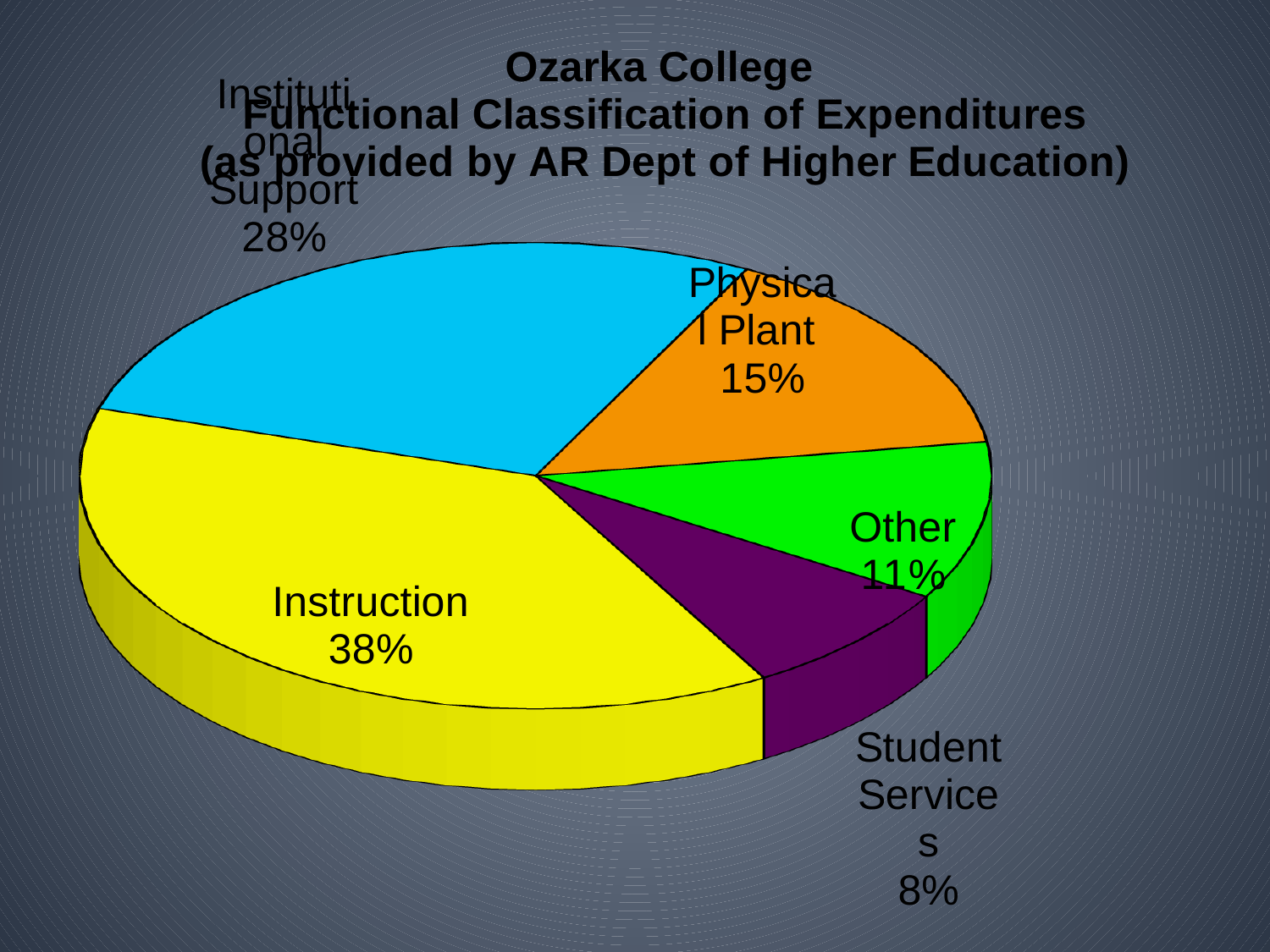
What percentage of expenditures goes to Institutional Support? 28% What percentage of expenditures goes to Instruction? 38% Which is larger, the share for Physical Plant or the share for Other? Physical Plant What percentage of expenditures goes to Student Services? 8% What percentage of expenditures is labelled Other? 11% How many categories are shown in the pie chart? 5 Which category has the largest share of expenditures? Instruction Which colour is used for the Instruction slice? Yellow Which category has the smallest share of expenditures? Student Services How many percentage points larger is Instruction than Institutional Support? 10 What kind of chart is shown on the slide? Pie chart What percentage of expenditures goes to Physical Plant? 15%